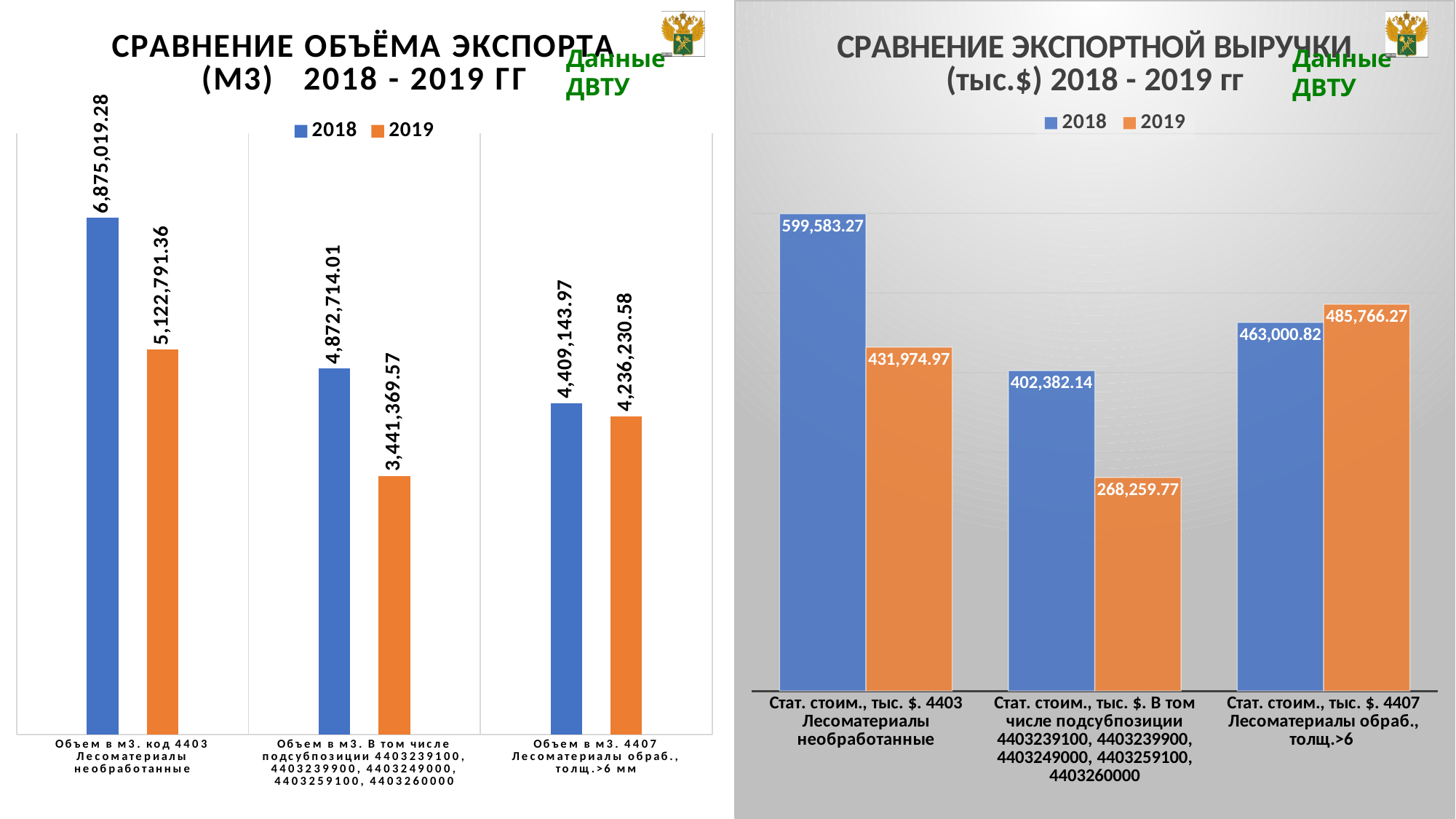
On the right chart (СРАВНЕНИЕ ЭКСПОРТНОЙ ВЫРУЧКИ), which is larger for 4407 Лесоматериалы обраб., толщ.>6: the 2018 value or the 2019 value? 2019 On the left chart (СРАВНЕНИЕ ОБЪЁМА ЭКСПОРТА), what is the difference between the 2018 and 2019 values for код 4403 Лесоматериалы необработанные? 1,752,227.92 On the left chart (СРАВНЕНИЕ ОБЪЁМА ЭКСПОРТА), which category has the lowest 2019 value? Объем в м3. В том числе подсубпозиции 4403239100, 4403239900, 4403249000, 4403259100, 4403260000 On the left chart (СРАВНЕНИЕ ОБЪЁМА ЭКСПОРТА), how many series does the legend list? 2 On the left chart (СРАВНЕНИЕ ОБЪЁМА ЭКСПОРТА), what is the 2019 value for the подсубпозиции category? 3,441,369.57 On the right chart (СРАВНЕНИЕ ЭКСПОРТНОЙ ВЫРУЧКИ), how many categories are shown on the x axis? 3 On the right chart (СРАВНЕНИЕ ЭКСПОРТНОЙ ВЫРУЧКИ), what is the 2019 value for 4407 Лесоматериалы обраб., толщ.>6? 485,766.27 On the right chart (СРАВНЕНИЕ ЭКСПОРТНОЙ ВЫРУЧКИ), what is the difference between the 2018 and 2019 values for 4403 Лесоматериалы необработанные? 167,608.30 On the left chart (СРАВНЕНИЕ ОБЪЁМА ЭКСПОРТА), what is the 2019 value for 4407 Лесоматериалы обраб., толщ.>6 мм? 4,236,230.58 On the right chart (СРАВНЕНИЕ ЭКСПОРТНОЙ ВЫРУЧКИ), what is the 2018 value for 4403 Лесоматериалы необработанные? 599,583.27 On the left chart (СРАВНЕНИЕ ОБЪЁМА ЭКСПОРТА), what is the 2018 value for код 4403 Лесоматериалы необработанные? 6,875,019.28 What type of chart is the right chart (СРАВНЕНИЕ ЭКСПОРТНОЙ ВЫРУЧКИ)? Bar chart